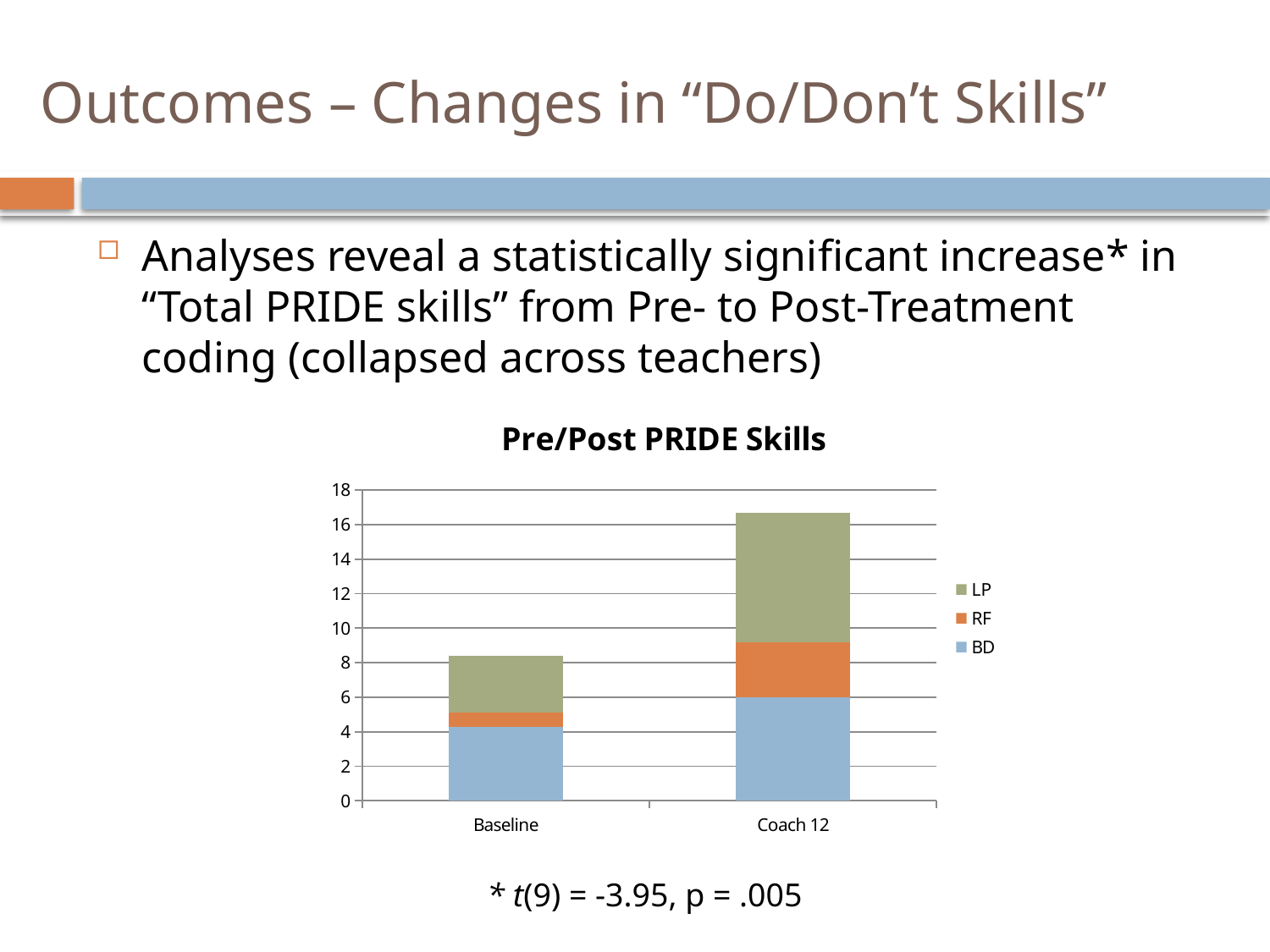
Is the BD segment for Baseline greater or less than 6? less What kind of chart is shown on the slide? stacked bar chart Which series is shown in green in the legend? LP What is the title of the chart? Pre/Post PRIDE Skills Is the total stacked bar for Coach 12 greater or less than 16? greater Which category has the taller stacked bar, Baseline or Coach 12? Coach 12 Is the total stacked bar for Baseline greater or less than 10? less Which category has the larger LP segment, Baseline or Coach 12? Coach 12 How many series does the legend list? 3 Does the total PRIDE skills value rise or fall from Baseline to Coach 12? rise How many categories are shown on the x axis? 2